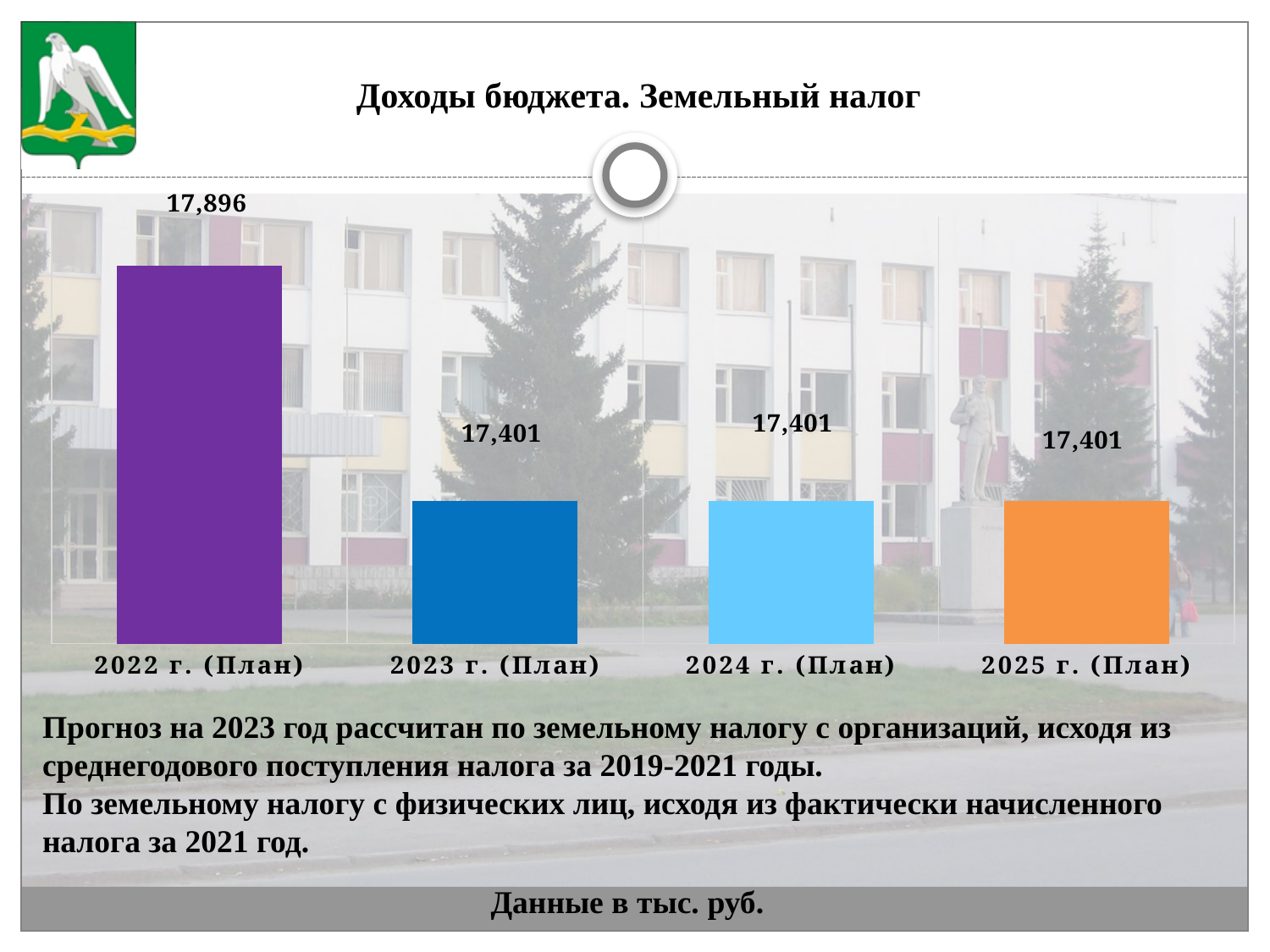
What is the value for 2025 г. (План)? 17,401 What is the difference between the values for 2022 г. (План) and 2023 г. (План)? 495 What is the total of the values for 2023 г. (План) and 2024 г. (План)? 34,802 What is the value for 2022 г. (План)? 17,896 What is the title of the chart? Доходы бюджета. Земельный налог What kind of chart is shown on the slide? Bar chart Which category has the highest value? 2022 г. (План) How many categories are shown on the chart? 4 Do the values rise or fall from 2022 г. (План) to 2023 г. (План)? Fall What colour is the bar for 2022 г. (План)? Purple What is the value for 2023 г. (План)? 17,401 Which is larger, the value for 2022 г. (План) or the value for 2024 г. (План)? 2022 г. (План)